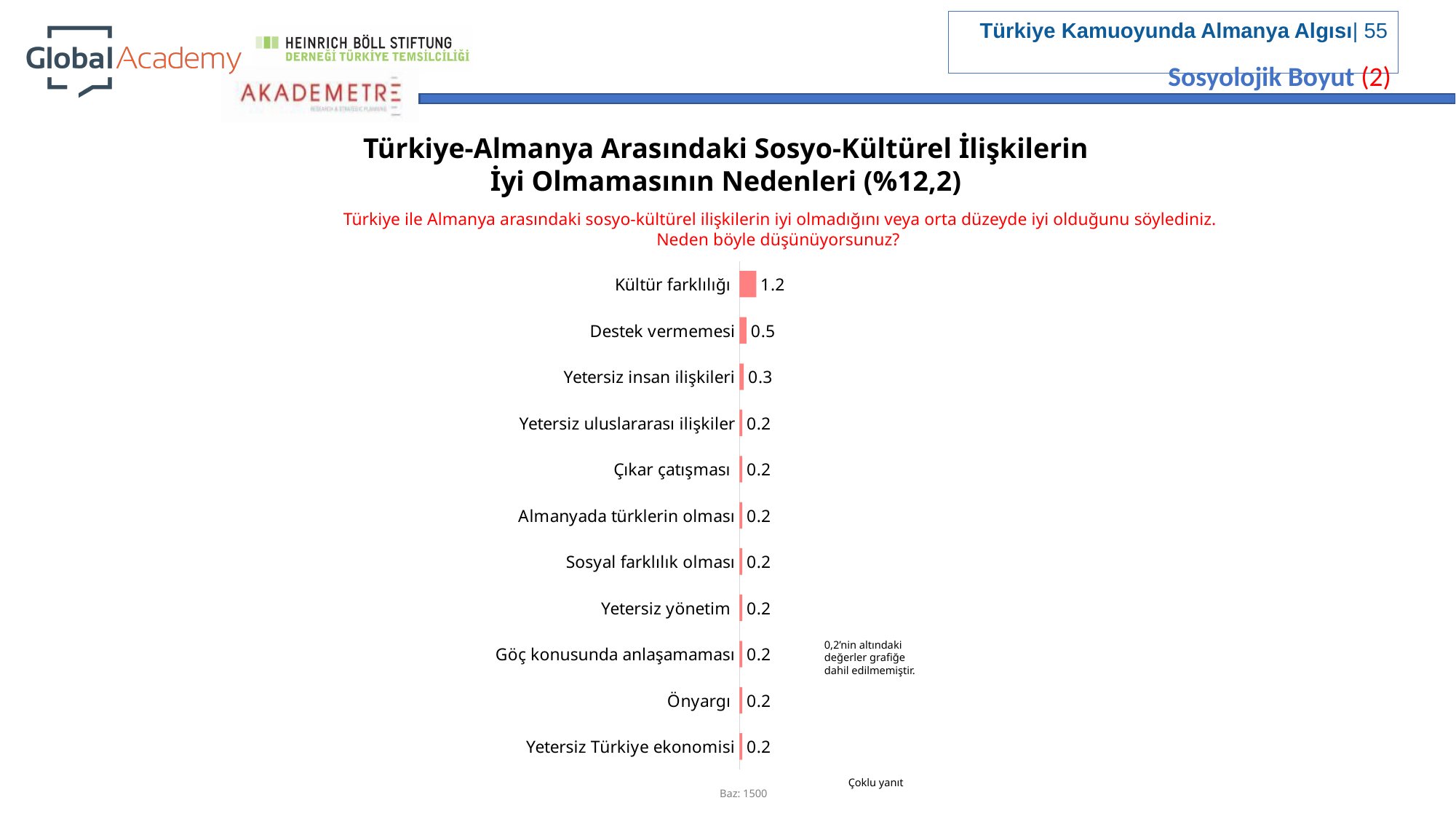
What is the difference between the values for Kültür farklılığı and Destek vermemesi? 0.7 What is the difference between the values for Destek vermemesi and Yetersiz insan ilişkileri? 0.2 Which category has the highest value? Kültür farklılığı How many categories have a value of 0.2? 8 What kind of chart is shown on the slide? Bar chart How many categories are shown in the chart? 11 What is the base (Baz) sample size noted below the chart? 1500 What is the value for Kültür farklılığı? 1.2 What is the value for Destek vermemesi? 0.5 Which is larger, the value for Kültür farklılığı or the value for Yetersiz insan ilişkileri? Kültür farklılığı What is the value for Yetersiz insan ilişkileri? 0.3 What is the value for Önyargı? 0.2